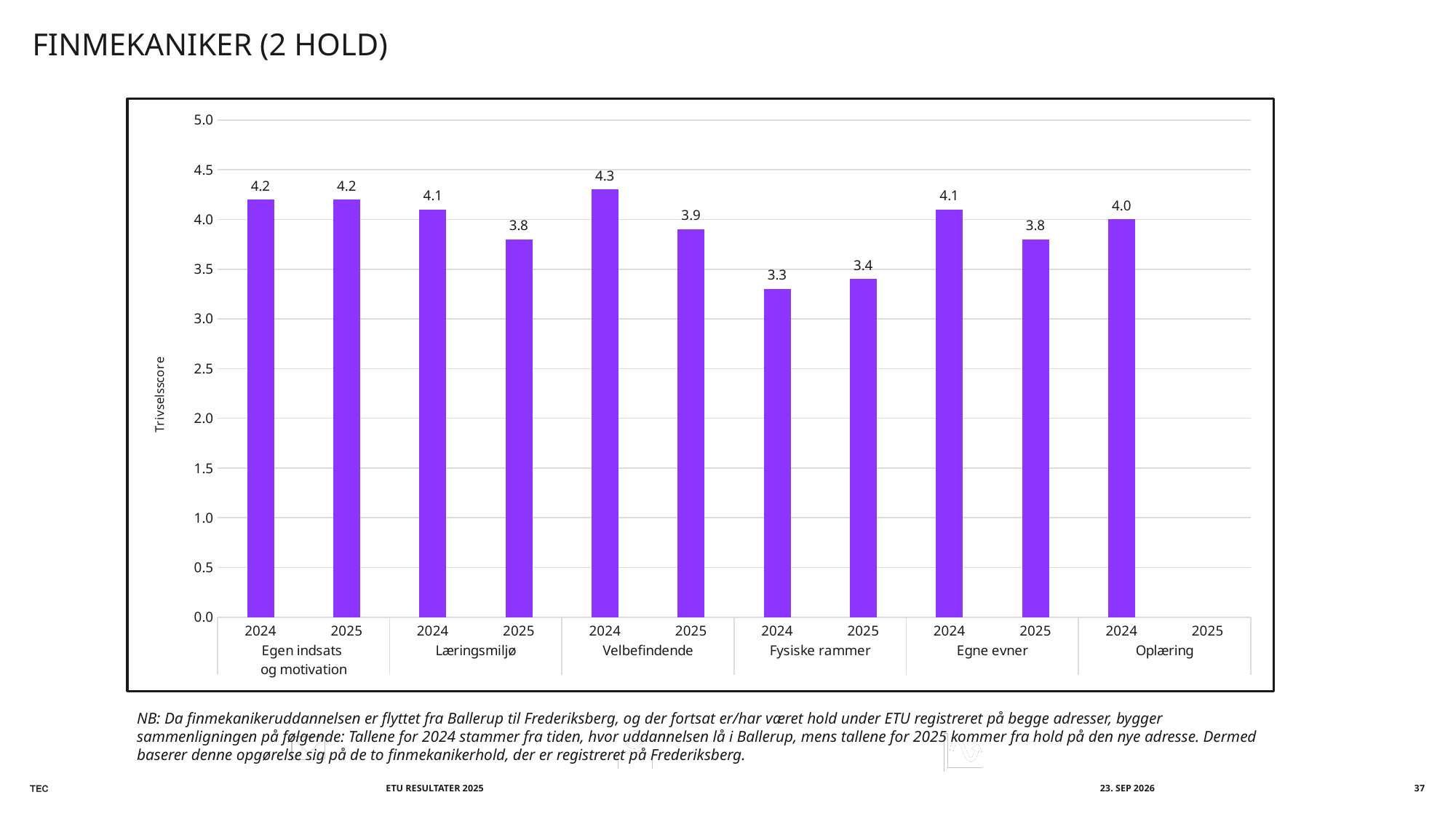
What is the value for Fysiske rammer in 2025? 3.4 What kind of chart is shown on the slide? Bar chart What is the difference between the 2024 and 2025 values for Egne evner? 0.3 What is the value for Velbefindende in 2024? 4.3 What is the label of the y axis? Trivselsscore How many category groups are shown on the x axis? 6 What is the difference between the 2024 and 2025 values for Velbefindende? 0.4 What is the value for Oplæring in 2024? 4.0 What is the value for Læringsmiljø in 2025? 3.8 Which is larger, the 2024 value for Læringsmiljø or the 2025 value for Læringsmiljø? 2024 Which bar has the lowest value on the chart? Fysiske rammer 2024 Which bar has the highest value on the chart? Velbefindende 2024